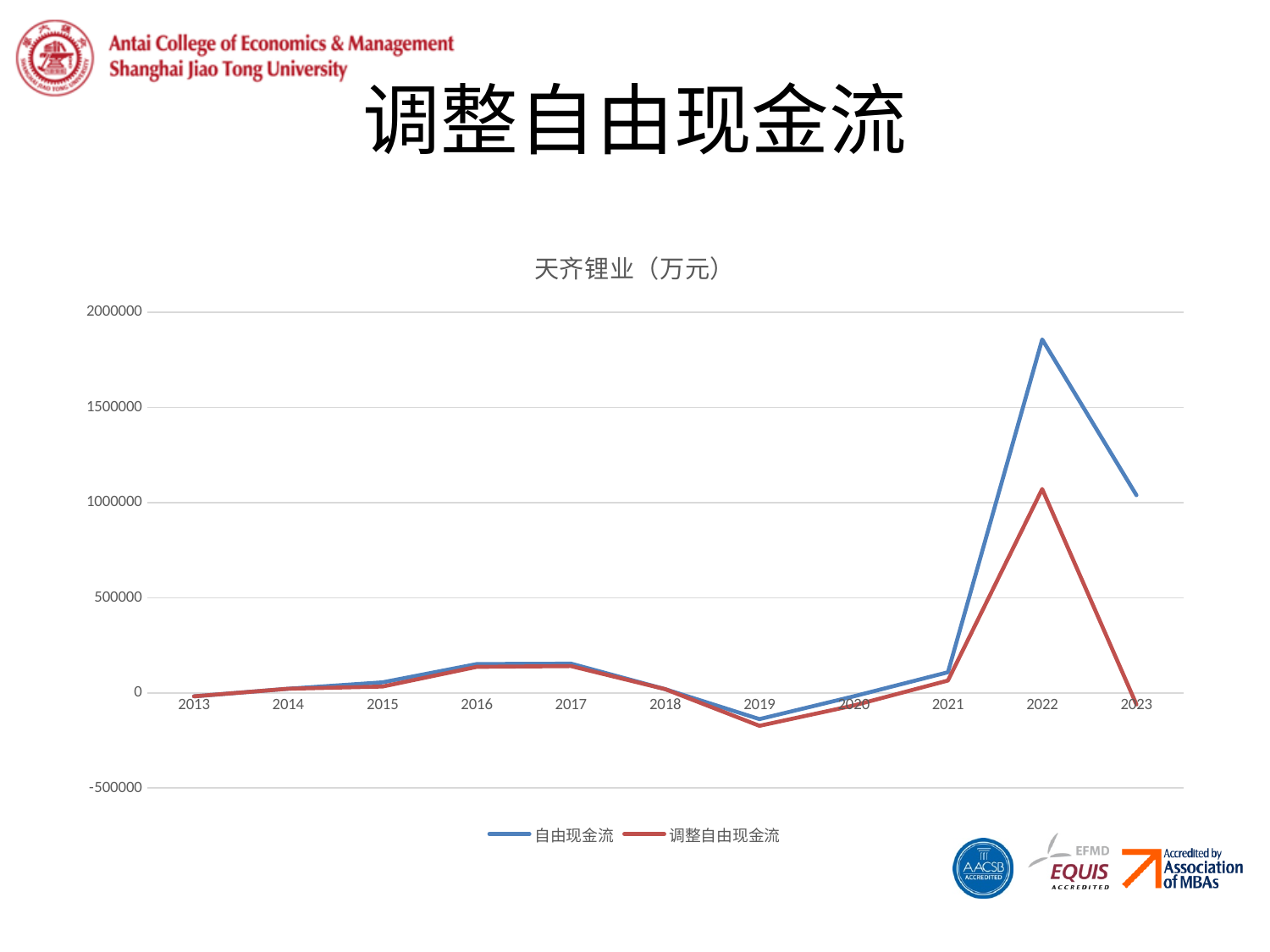
In which year is 调整自由现金流 at its lowest? 2019 In which year does 自由现金流 reach its highest value? 2022 In which year does 调整自由现金流 reach its highest value? 2022 Is the value of 调整自由现金流 in 2019 greater or less than 0? less What is the title of the chart? 天齐锂业（万元） Is the value of 自由现金流 in 2022 greater or less than 1500000? greater Which series is drawn in red? 调整自由现金流 How many series does the legend list? 2 Do both series rise or fall from 2022 to 2023? fall What kind of chart is shown on the slide? line chart How many years are plotted along the x axis? 11 In 2022, which series has the larger value, 自由现金流 or 调整自由现金流? 自由现金流